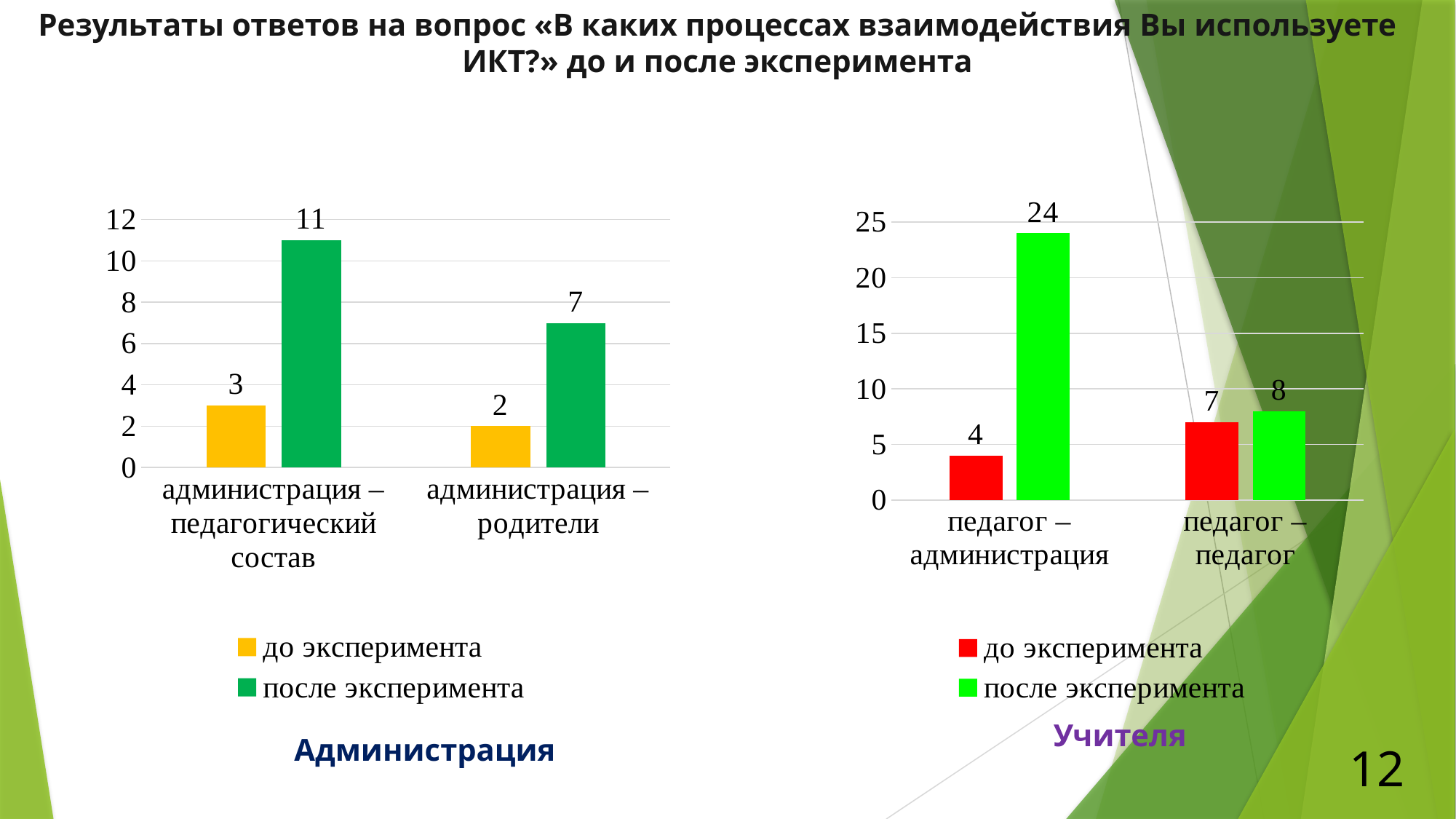
In the left chart (Администрация), what is the value for «администрация – педагогический состав» after the experiment (после эксперимента)? 11 In the right chart (Учителя), which category has the highest value after the experiment? педагог – администрация How many series does the legend of the right chart (Учителя) list? 2 In the right chart (Учителя), what is the value for «педагог – педагог» before the experiment (до эксперимента)? 7 In the right chart (Учителя), what is the value for «педагог – администрация» after the experiment (после эксперимента)? 24 In the right chart (Учителя), which is larger for «педагог – педагог»: the value before the experiment or after the experiment? после эксперимента In the left chart (Администрация), what is the difference between the after-experiment and before-experiment values for «администрация – педагогический состав»? 8 In the left chart (Администрация), what is the value for «администрация – родители» before the experiment (до эксперимента)? 2 In the right chart (Учителя), what is the difference between the after-experiment values for «педагог – администрация» and «педагог – педагог»? 16 How many categories are shown on the x axis of the left chart (Администрация)? 2 In the left chart (Администрация), which category has the lowest value before the experiment? администрация – родители What type of chart is the left chart (Администрация)? bar chart